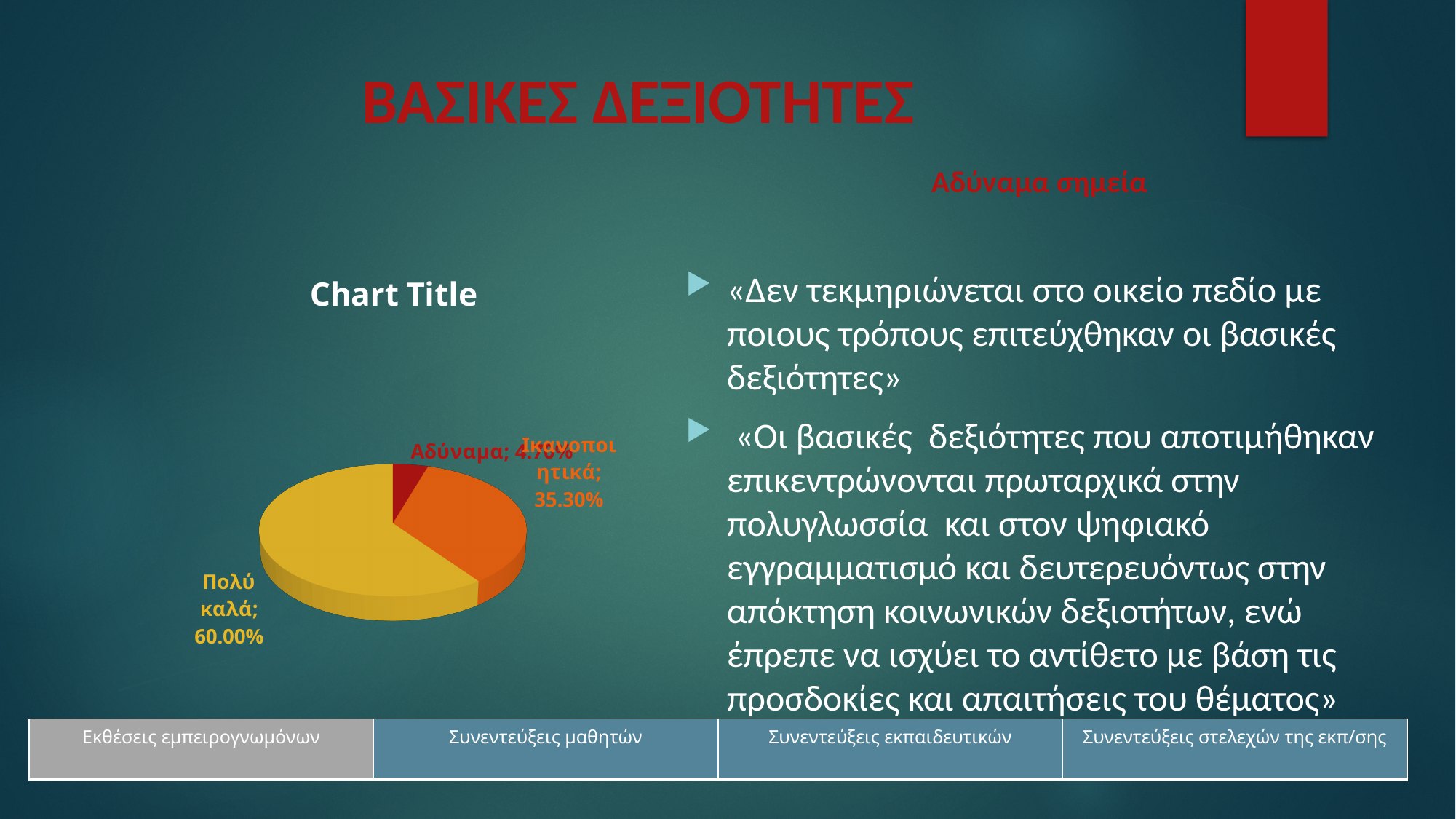
What is the difference between the values for Πολύ καλά and Ικανοποιητικά? 24.70% Which category has the smallest slice in the pie chart? Αδύναμα What is the value for Ικανοποιητικά in the pie chart? 35.30% What kind of chart is shown on the slide? pie chart What is the title shown above the pie chart? Chart Title What colour is the Πολύ καλά slice in the pie chart? yellow What is the value for Πολύ καλά in the pie chart? 60.00% Which is larger, the slice for Πολύ καλά or the slice for Ικανοποιητικά? Πολύ καλά Which category has the largest slice in the pie chart? Πολύ καλά How many slices does the pie chart have? 3